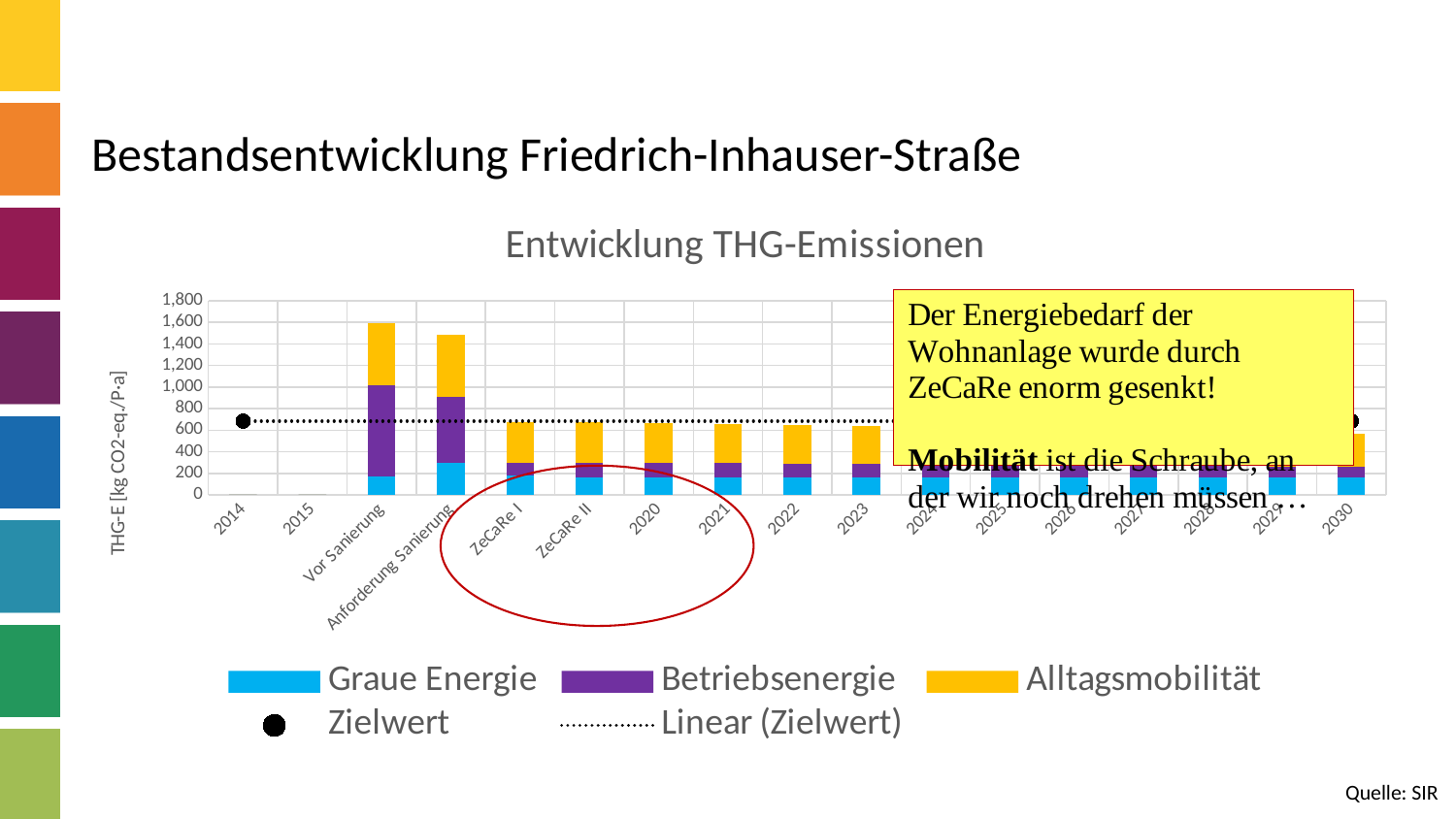
How many entries does the chart legend list? 5 Is the total value for Anforderung Sanierung greater or less than 1,200? greater How many categories are shown on the x axis of the chart? 17 Which category has the highest total bar in the chart? Vor Sanierung What is the label of the y axis of the chart? THG-E [kg CO2-eq./P·a] What is the title of the chart? Entwicklung THG-Emissionen Is the total value for Vor Sanierung greater or less than 1,400? greater What kind of chart is shown on the slide? stacked bar chart Which has the larger total bar, Vor Sanierung or ZeCaRe I? Vor Sanierung Do the total bar values rise or fall from Vor Sanierung to 2030? fall Is the total value for ZeCaRe I greater or less than 800? less